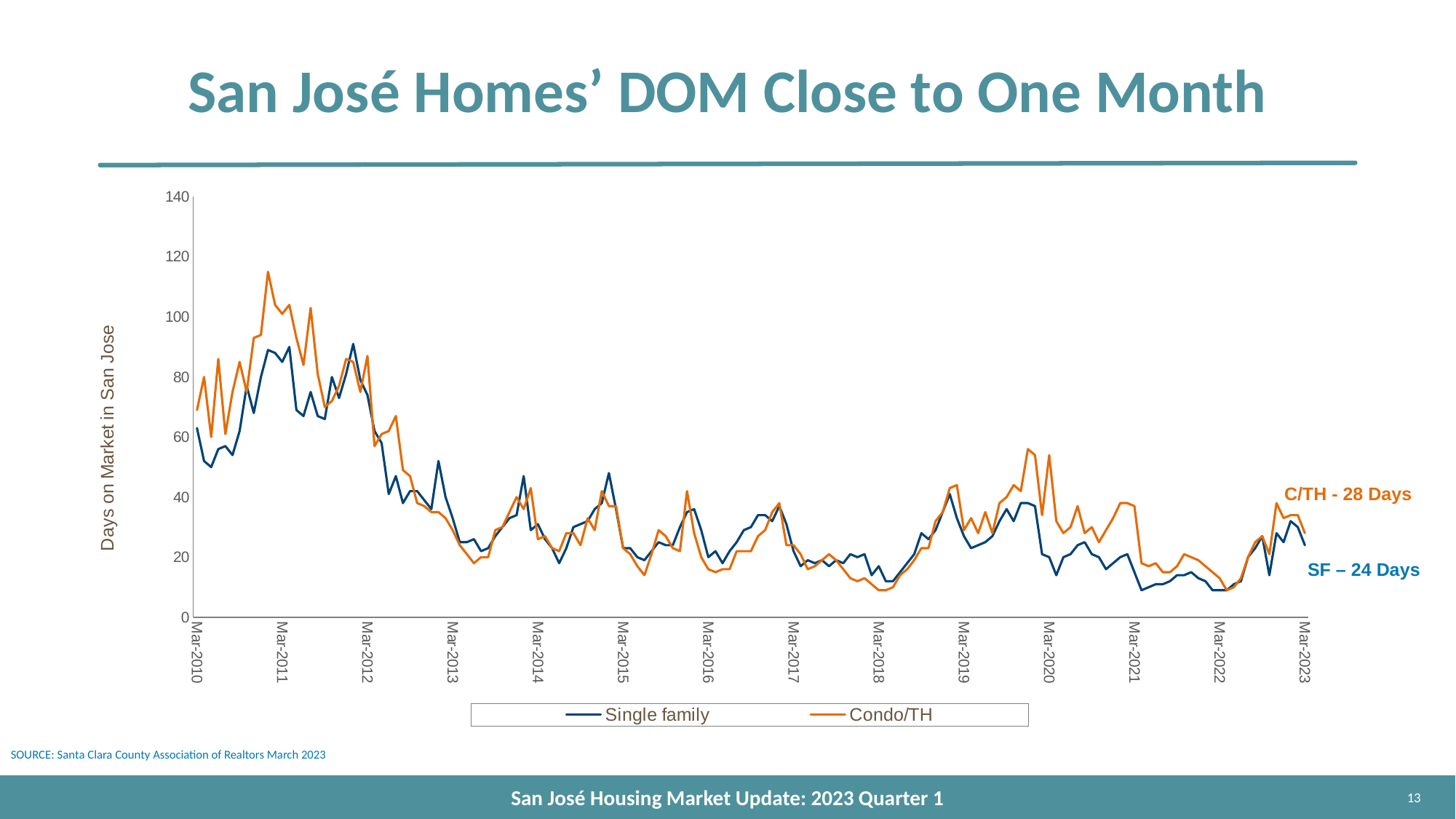
Overall, do days on market rise or fall from Mar-2010 to Mar-2023? Fall What is the difference between the Condo/TH and Single family days on market at Mar-2023? 4 days What is the label on the vertical axis of the chart? Days on Market in San Jose Which series reaches the highest days on market value anywhere on the chart? Condo/TH What kind of chart is shown on the slide? Line chart What is the Condo/TH days on market value labelled for Mar-2023? 28 Days Is the Condo/TH peak around Mar-2020 greater or less than 40? greater How many series does the legend list? 2 At Mar-2023, which series has the higher days on market, Single family or Condo/TH? Condo/TH Is the peak Condo/TH value around Mar-2011 greater or less than 100? greater Is the Single family value around Mar-2018 greater or less than 20? less What is the Single family days on market value labelled for Mar-2023? 24 Days